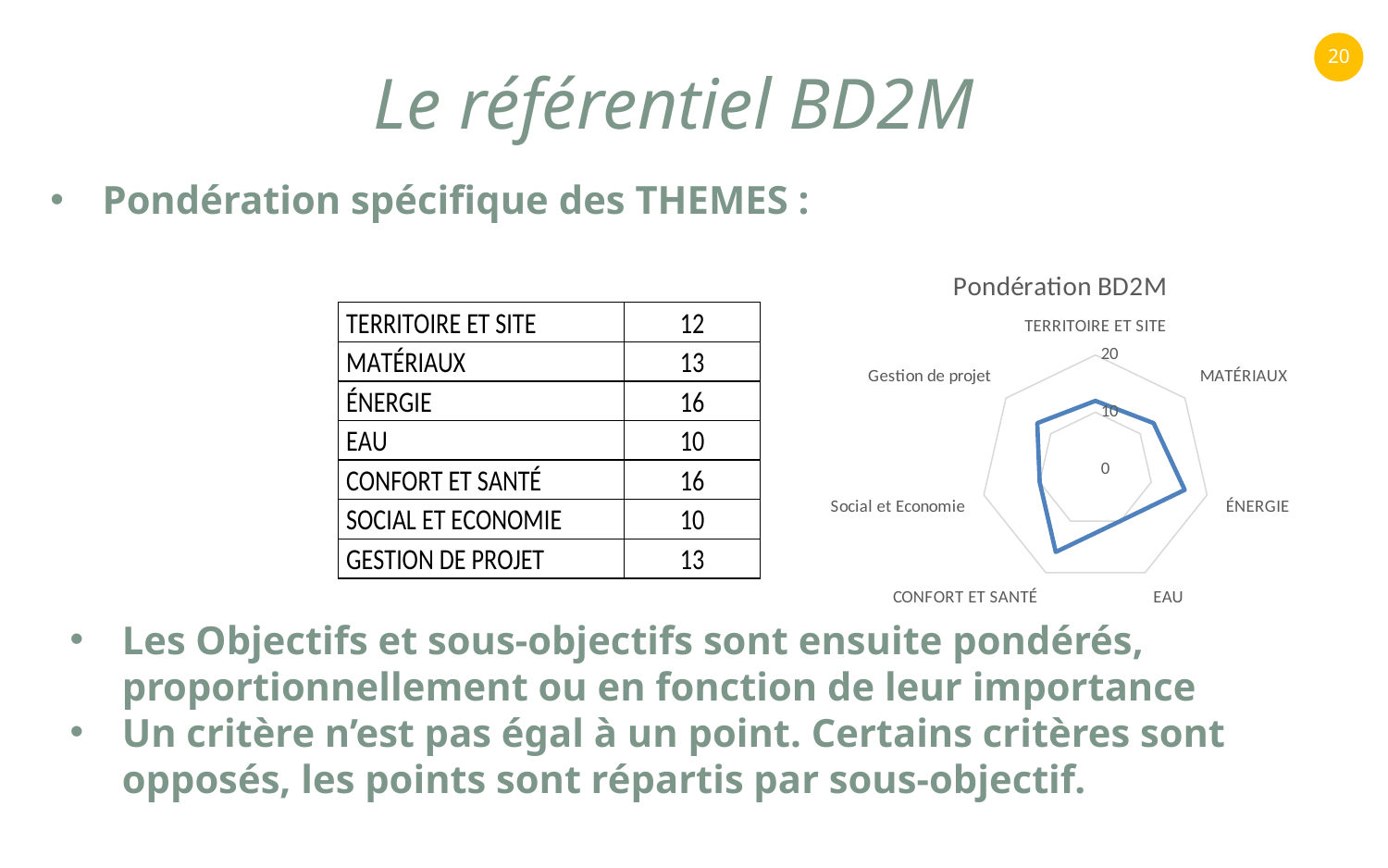
In the chart "Pondération BD2M", which is larger: ÉNERGIE or EAU? ÉNERGIE In the chart "Pondération BD2M", is the value for ÉNERGIE greater or less than 10? greater What kind of chart is "Pondération BD2M"? Radar chart In the chart "Pondération BD2M", is the value for CONFORT ET SANTÉ greater or less than 20? less What is the title of the chart on the slide? Pondération BD2M In the chart "Pondération BD2M", which is larger: CONFORT ET SANTÉ or Social et Economie? CONFORT ET SANTÉ In the chart "Pondération BD2M", what is the value for Gestion de projet? 13 In the chart "Pondération BD2M", what is the value for EAU? 10 In the chart "Pondération BD2M", what is the difference between the values for ÉNERGIE and EAU? 6 In the chart "Pondération BD2M", what is the value for TERRITOIRE ET SITE? 12 In the chart "Pondération BD2M", what is the value for ÉNERGIE? 16 How many categories (axes) does the radar chart "Pondération BD2M" have? 7